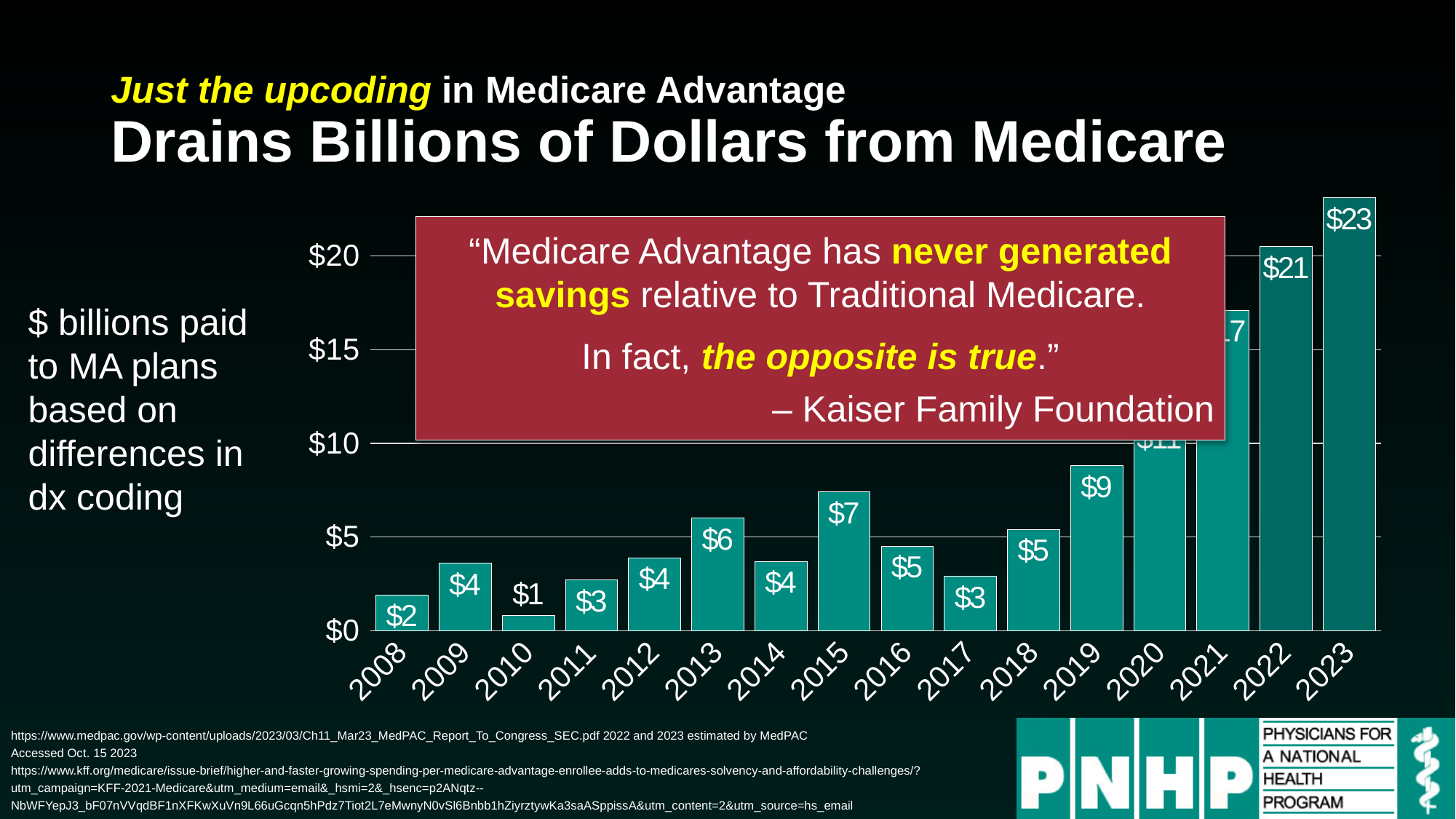
What is the value for 2022? $21 What is the difference between the values for 2023 and 2022? $2 What kind of chart is shown on the slide? bar chart Do the values generally rise or fall from 2017 to 2023? rise What is the value for 2023? $23 What is the value for 2015? $7 How many years are shown on the x axis? 16 Which year has the highest value? 2023 What is the value for 2019? $9 Is the value for 2022 greater or less than $20? greater Which is larger, the value for 2013 or the value for 2017? 2013 Which year has the lowest value? 2010